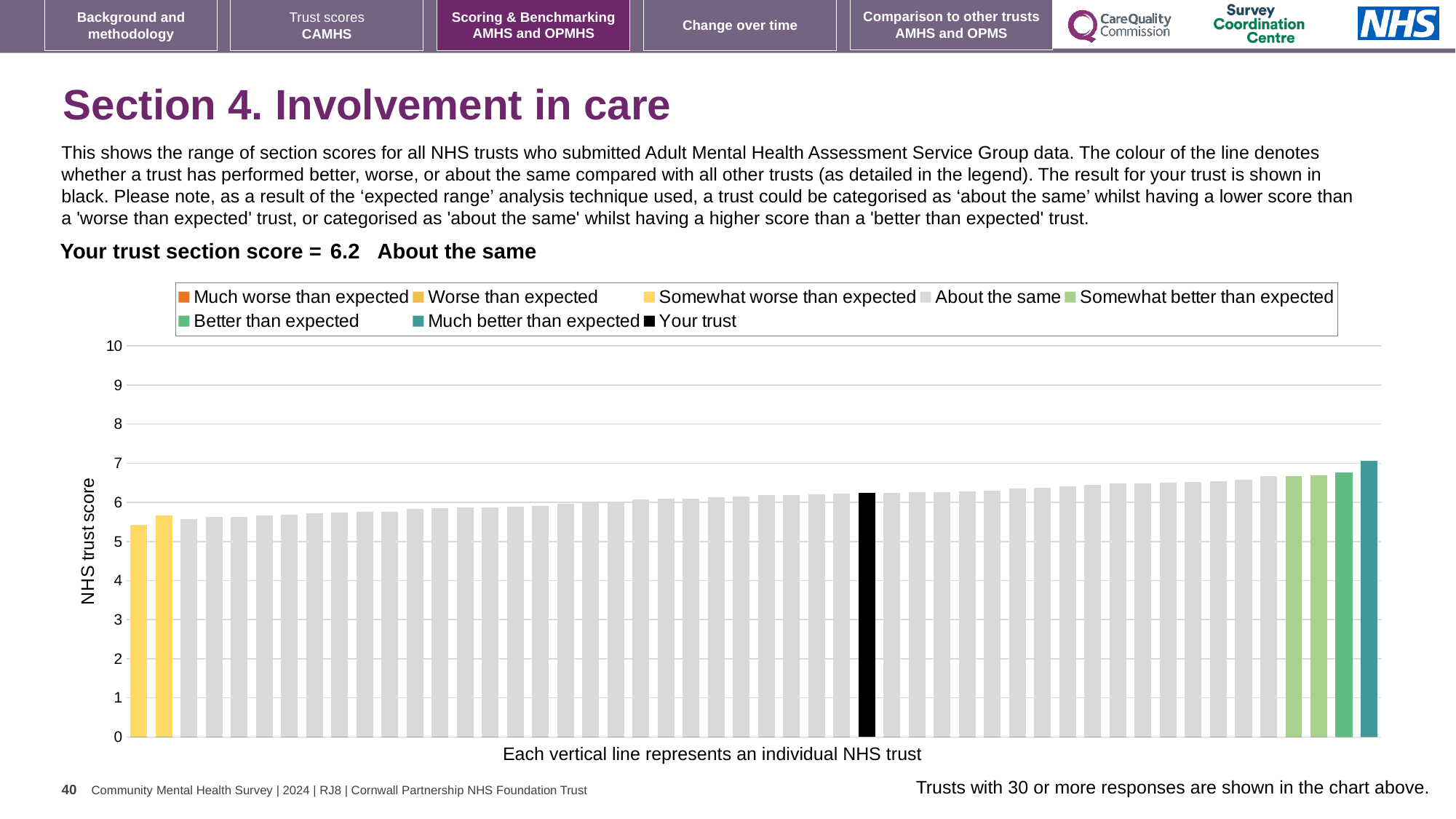
What colour is used for the 'Your trust' bar in the chart? black What is your trust's section score for Involvement in care? 6.2 Which legend category does the tallest bar in the chart belong to? Much better than expected Is the value of the lowest bar in the chart greater or less than 6? less How many entries does the chart legend list? 8 Do the bar values rise or fall from left to right along the x axis? rise What kind of chart is shown on the slide? bar chart Is the value of the lowest bar in the chart greater or less than 5? greater Is the value of the black 'Your trust' bar greater or less than 6? greater Which legend category does the shortest bar in the chart belong to? Somewhat worse than expected What is the label on the vertical axis of the chart? NHS trust score